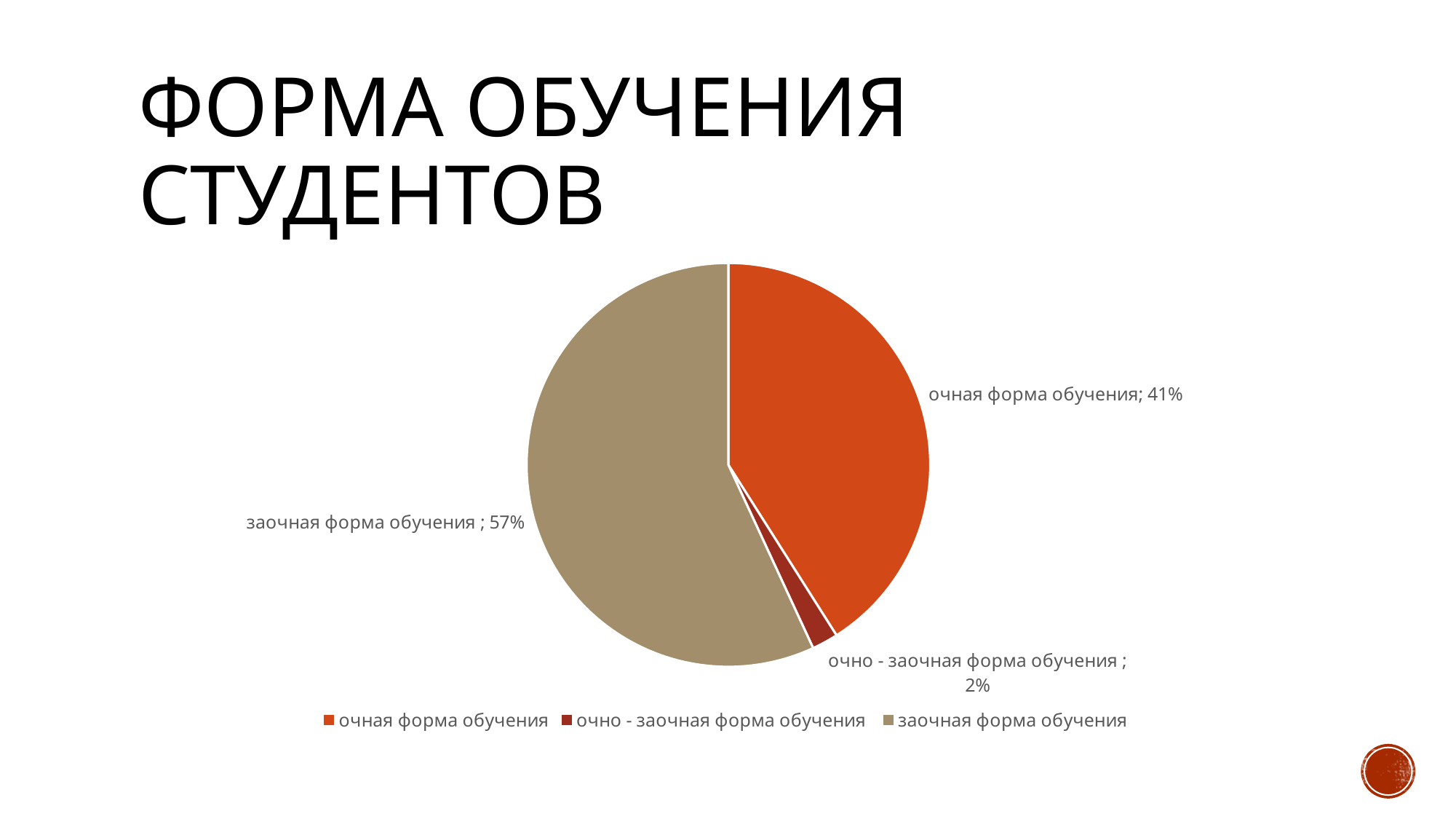
How many categories are shown in the pie chart? 3 What share of the pie does 'очно - заочная форма обучения' represent? 2% What is the title of the slide? ФОРМА ОБУЧЕНИЯ СТУДЕНТОВ What kind of chart is shown on the slide? pie chart Which form of study has the smallest slice of the pie? очно - заочная форма обучения How many entries does the legend list? 3 Which form of study has the largest slice of the pie? заочная форма обучения What is the difference in percentage points between 'очная форма обучения' and 'очно - заочная форма обучения'? 39 Which is larger: the share for 'очная форма обучения' or for 'заочная форма обучения'? заочная форма обучения What is the difference in percentage points between 'заочная форма обучения' and 'очная форма обучения'? 16 What share of the pie does 'очная форма обучения' represent? 41% What share of the pie does 'заочная форма обучения' represent? 57%